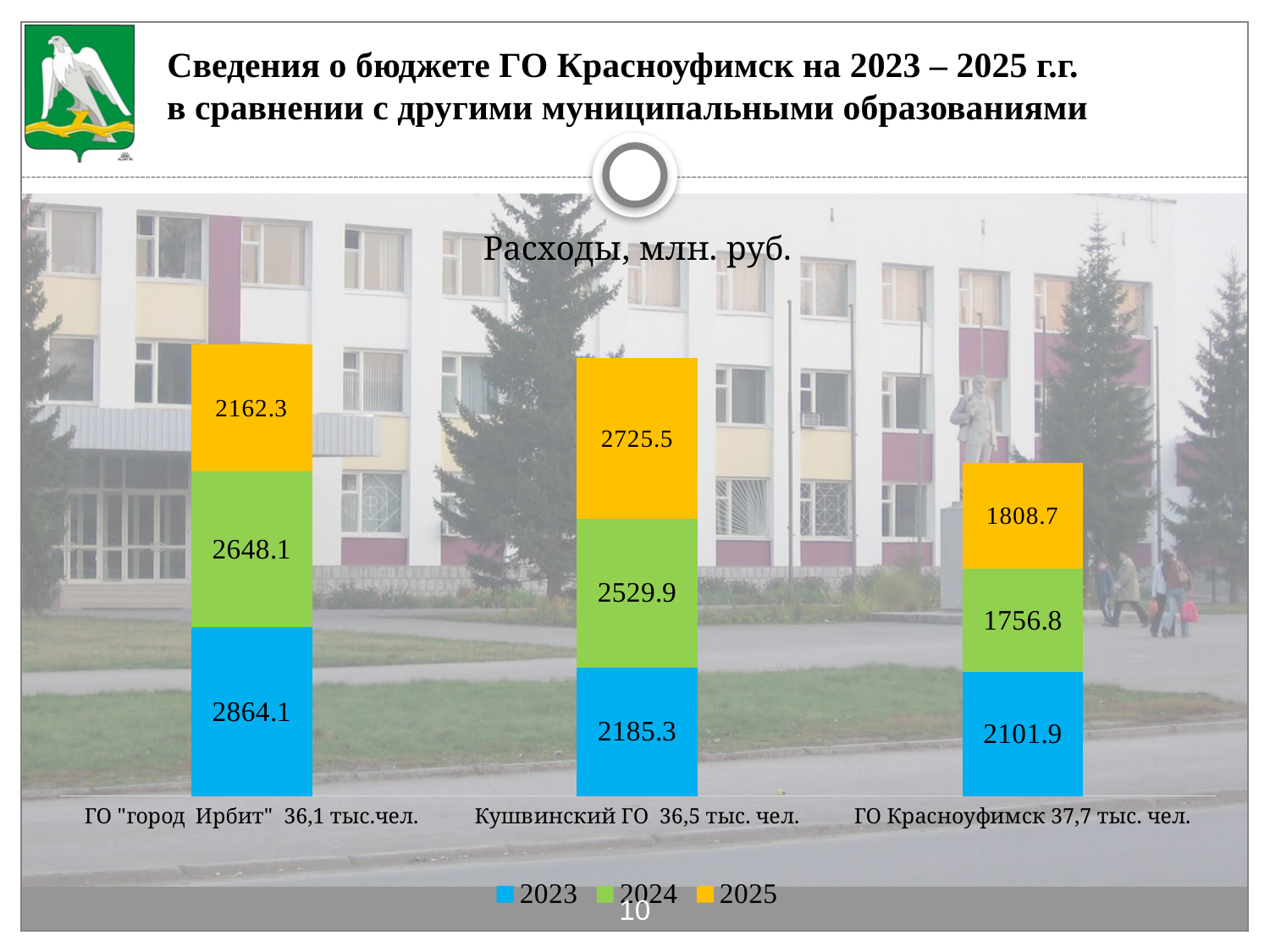
What kind of chart is shown on the slide? stacked bar chart Which municipality has the highest 2025 value? Кушвинский ГО What is the total of the stacked bar for ГО Красноуфимск? 5667.4 What is the 2024 value for ГО Красноуфимск? 1756.8 Which is larger: the 2024 value for ГО "город Ирбит" or the 2024 value for Кушвинский ГО? ГО "город Ирбит" Which municipality has the lowest 2023 value? ГО Красноуфимск How many municipalities (categories) are shown on the x axis? 3 What is the difference between the 2023 values for ГО "город Ирбит" and ГО Красноуфимск? 762.2 What is the 2023 value for ГО "город Ирбит"? 2864.1 What is the 2025 value for Кушвинский ГО? 2725.5 What is the title of the chart? Расходы, млн. руб. How many series does the legend list? 3